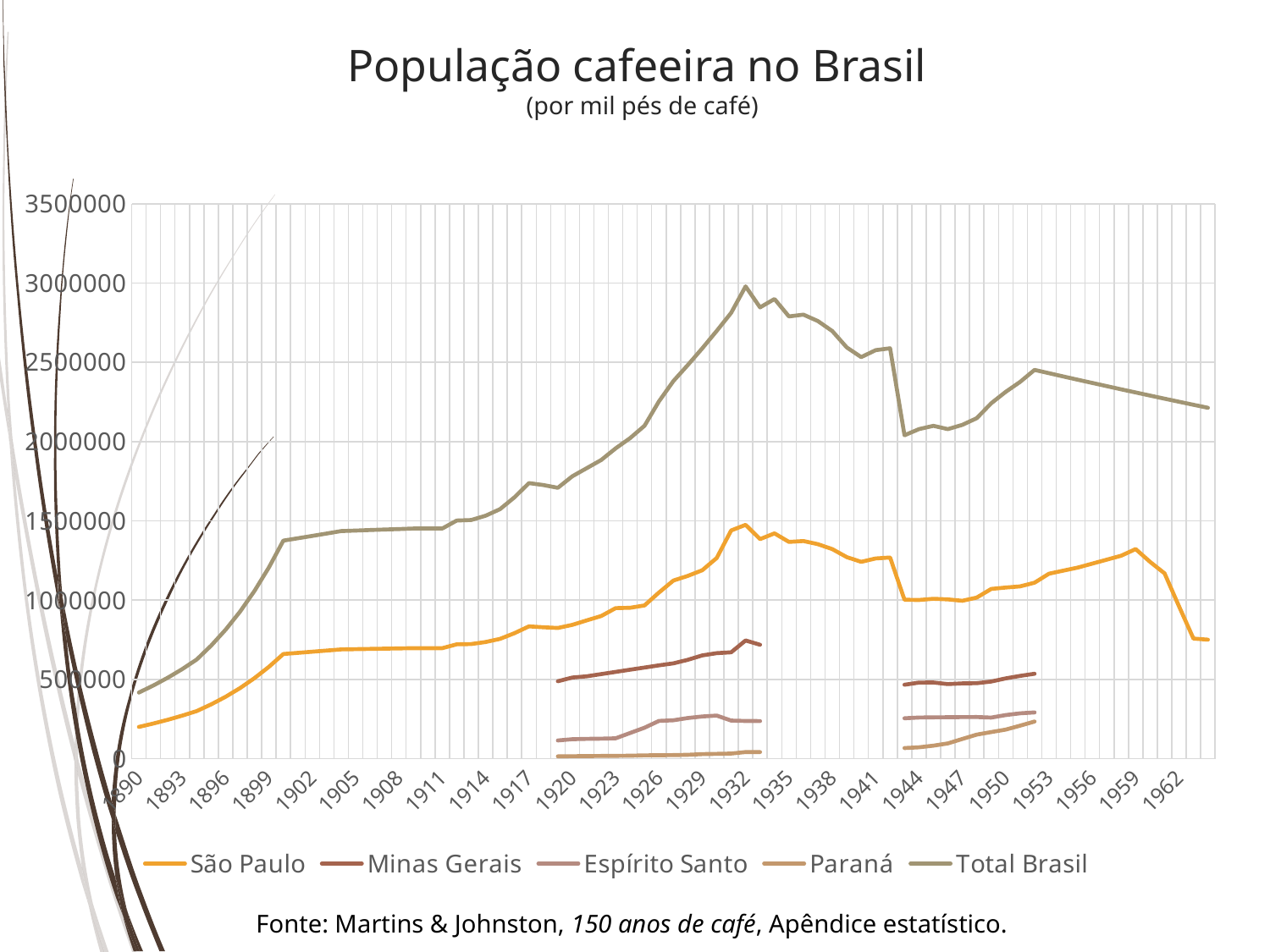
In 1932, which is larger: the value for São Paulo or the value for Minas Gerais? São Paulo What kind of chart is shown on the slide? line chart Is the value for Total Brasil in 1890 greater or less than 500000? less What unit does the subtitle say the values are in? por mil pés de café Is the peak value of Total Brasil greater or less than 2500000? greater What is the title of the chart? População cafeeira no Brasil Is the value for Paraná in 1920 greater or less than 500000? less How many series does the legend list? 5 Does the Total Brasil series rise or fall between 1890 and 1932? rise Which series has the lowest values on the chart? Paraná Which series reaches the highest value on the chart? Total Brasil